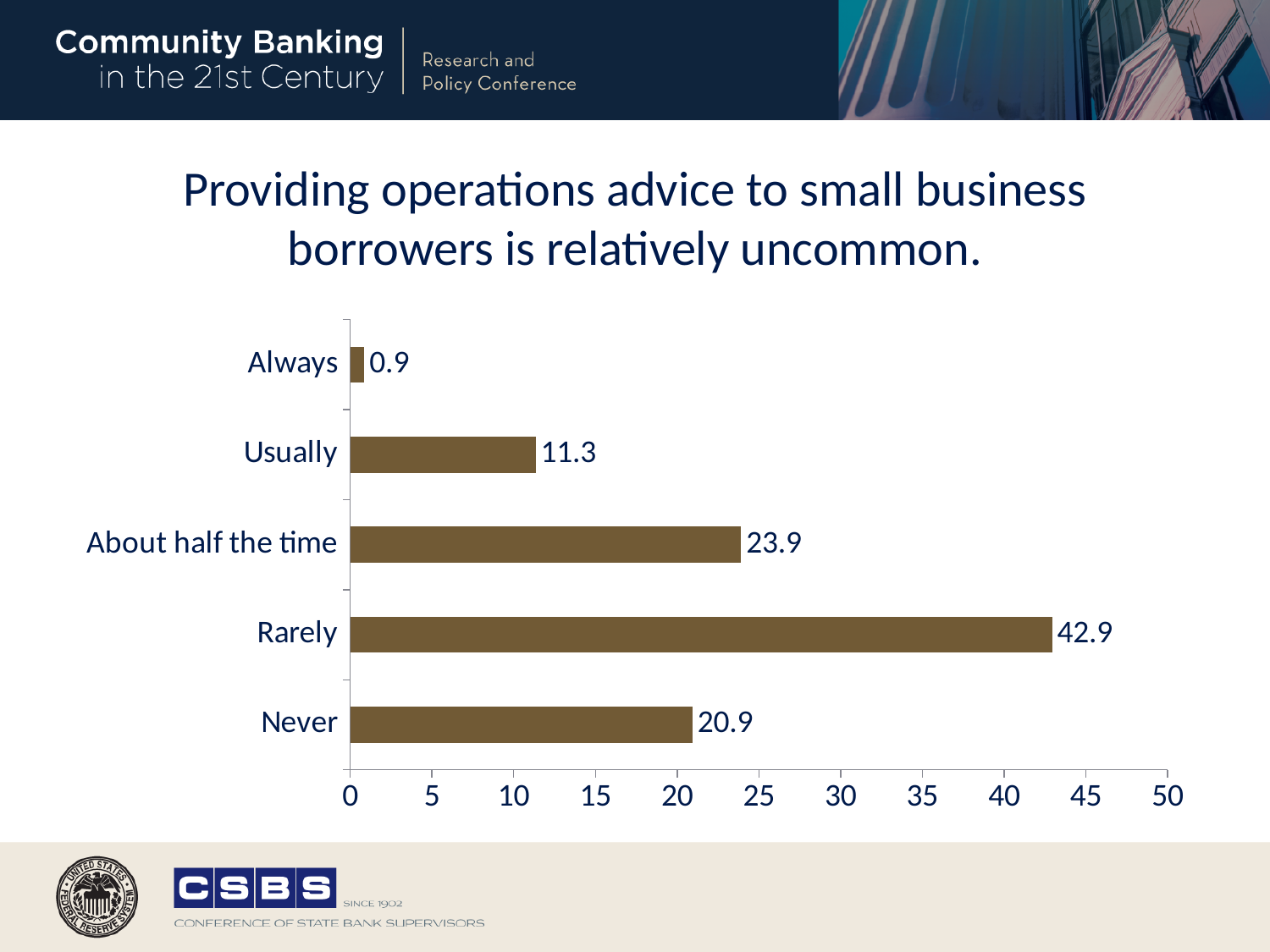
What is the value for Always? 0.9 What is the value for About half the time? 23.9 Is the value for Rarely greater or less than 40? greater What kind of chart is shown on the slide? Bar chart Which is larger, the value for Usually or the value for Never? Never What is the difference between the values for Rarely and Never? 22.0 Which category has the lowest value? Always What is the value for Never? 20.9 What is the value for Rarely? 42.9 How many categories are shown in the chart? 5 What is the difference between the values for About half the time and Usually? 12.6 Which category has the highest value? Rarely